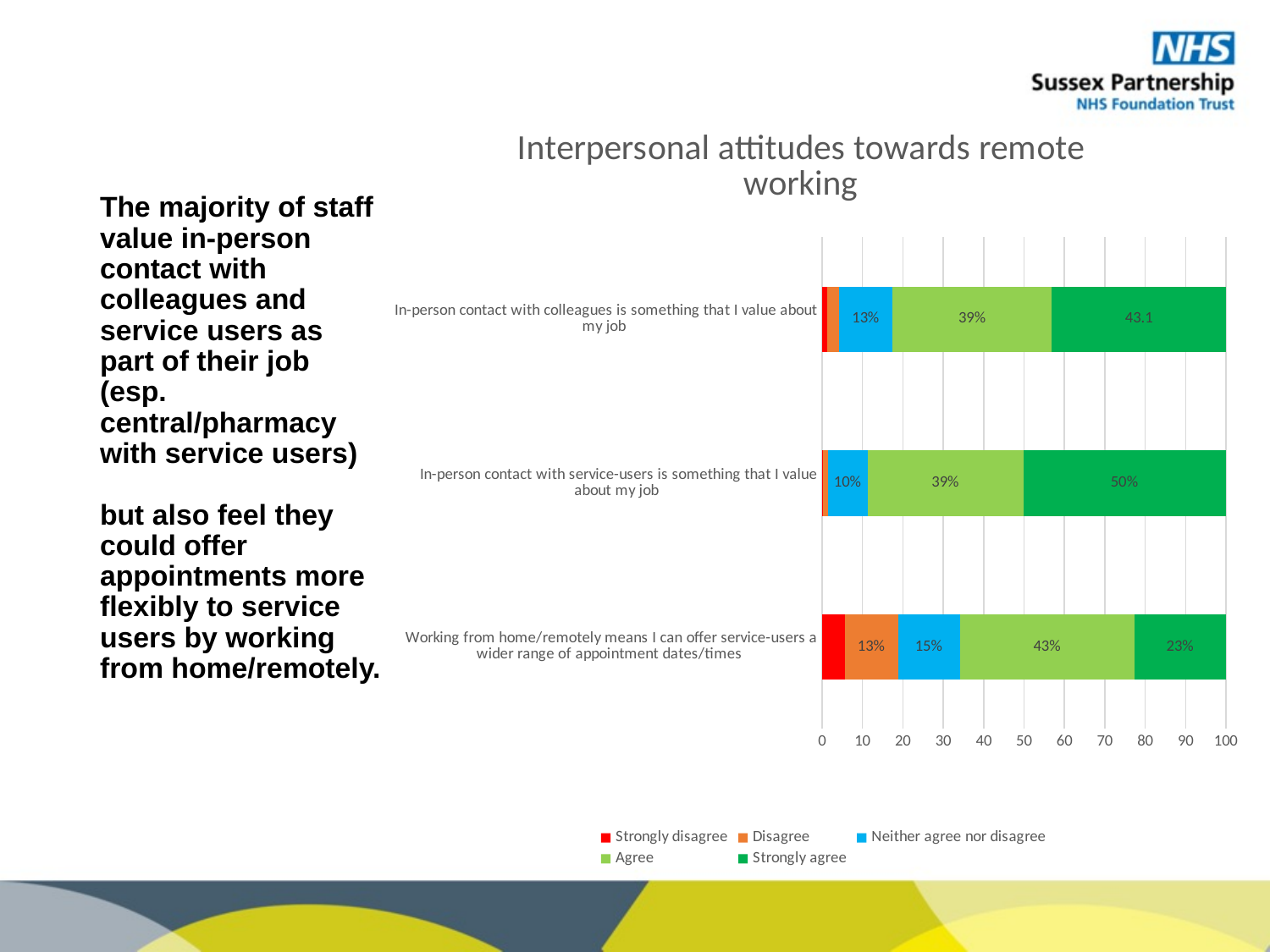
How many series does the legend list? 5 What kind of chart is shown on the slide? stacked bar chart How many statements (categories) are plotted in the chart? 3 What is the 'Strongly agree' value for 'In-person contact with service-users is something that I value about my job'? 50% What is the difference between the 'Strongly agree' values for 'In-person contact with service-users' and 'Working from home/remotely means I can offer service-users a wider range of appointment dates/times'? 27% What is the 'Strongly agree' value for 'In-person contact with colleagues is something that I value about my job'? 43.1 Which is larger: the 'Disagree' value for 'Working from home/remotely means I can offer service-users a wider range of appointment dates/times' or the 'Disagree' value for 'In-person contact with service-users is something that I value about my job'? Working from home/remotely means I can offer service-users a wider range of appointment dates/times What is the 'Agree' value for 'Working from home/remotely means I can offer service-users a wider range of appointment dates/times'? 43% What is the title of the chart? Interpersonal attitudes towards remote working Which statement has the highest 'Strongly agree' value? In-person contact with service-users is something that I value about my job Which statement has the lowest 'Strongly agree' value? Working from home/remotely means I can offer service-users a wider range of appointment dates/times What is the 'Neither agree nor disagree' value for 'Working from home/remotely means I can offer service-users a wider range of appointment dates/times'? 15%